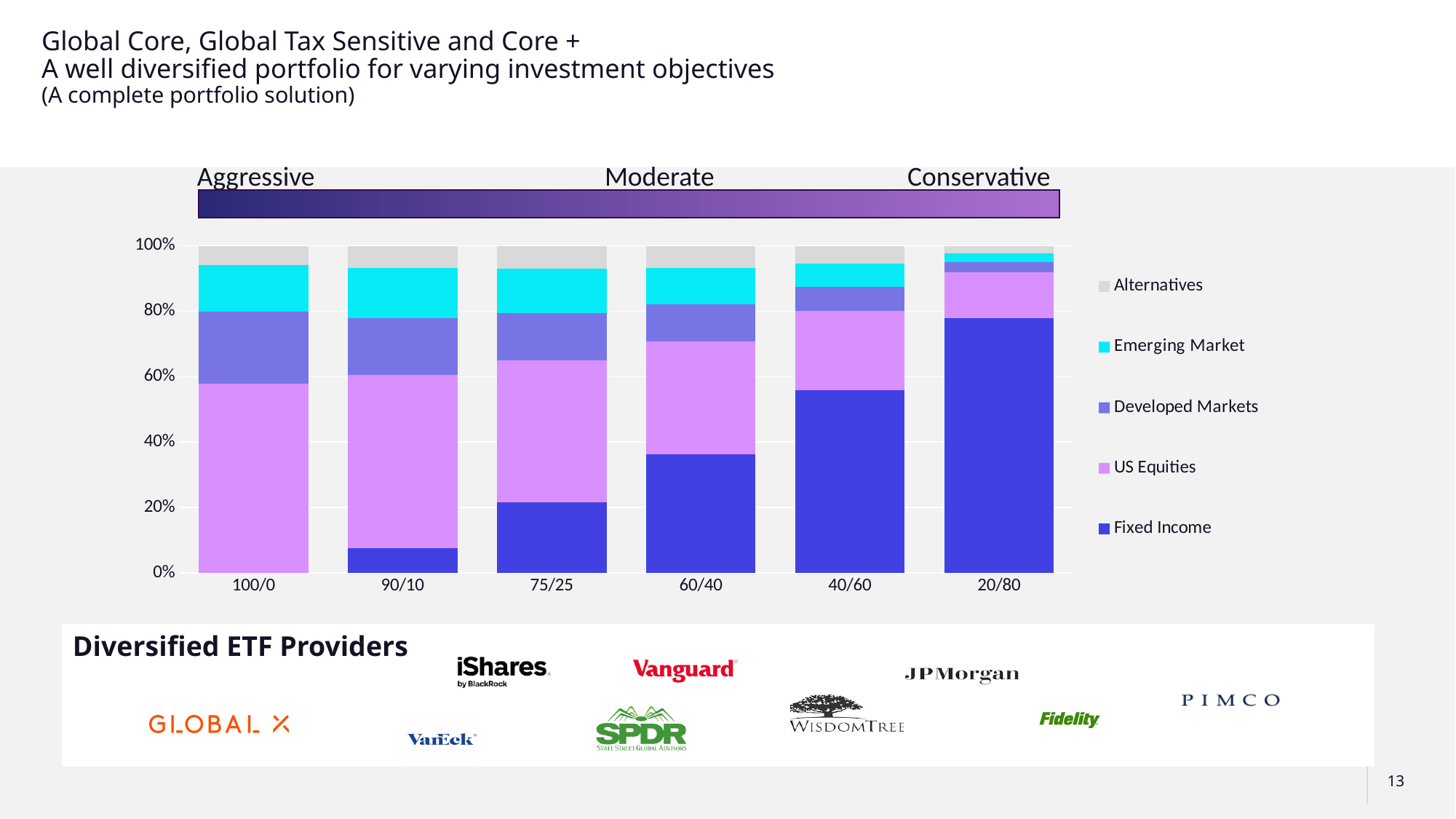
Which portfolio allocation has the largest Fixed Income share? 20/80 What kind of chart is shown on the slide? Stacked bar chart How many portfolio allocations (categories) are shown on the x axis? 6 Is the Fixed Income value for the 60/40 portfolio greater or less than 40%? less What three risk labels appear above the gradient bar over the chart? Aggressive, Moderate, Conservative Does the Fixed Income share rise or fall moving from 100/0 to 20/80 along the x axis? Rises How many series does the legend list? 5 What is the total height of each stacked bar? 100% Is the US Equities value for the 100/0 portfolio greater or less than 40%? greater Which has a larger Fixed Income share, the 75/25 portfolio or the 60/40 portfolio? 60/40 Which portfolio allocation has the smallest Fixed Income share? 100/0 Is the Fixed Income value for the 40/60 portfolio greater or less than 40%? greater